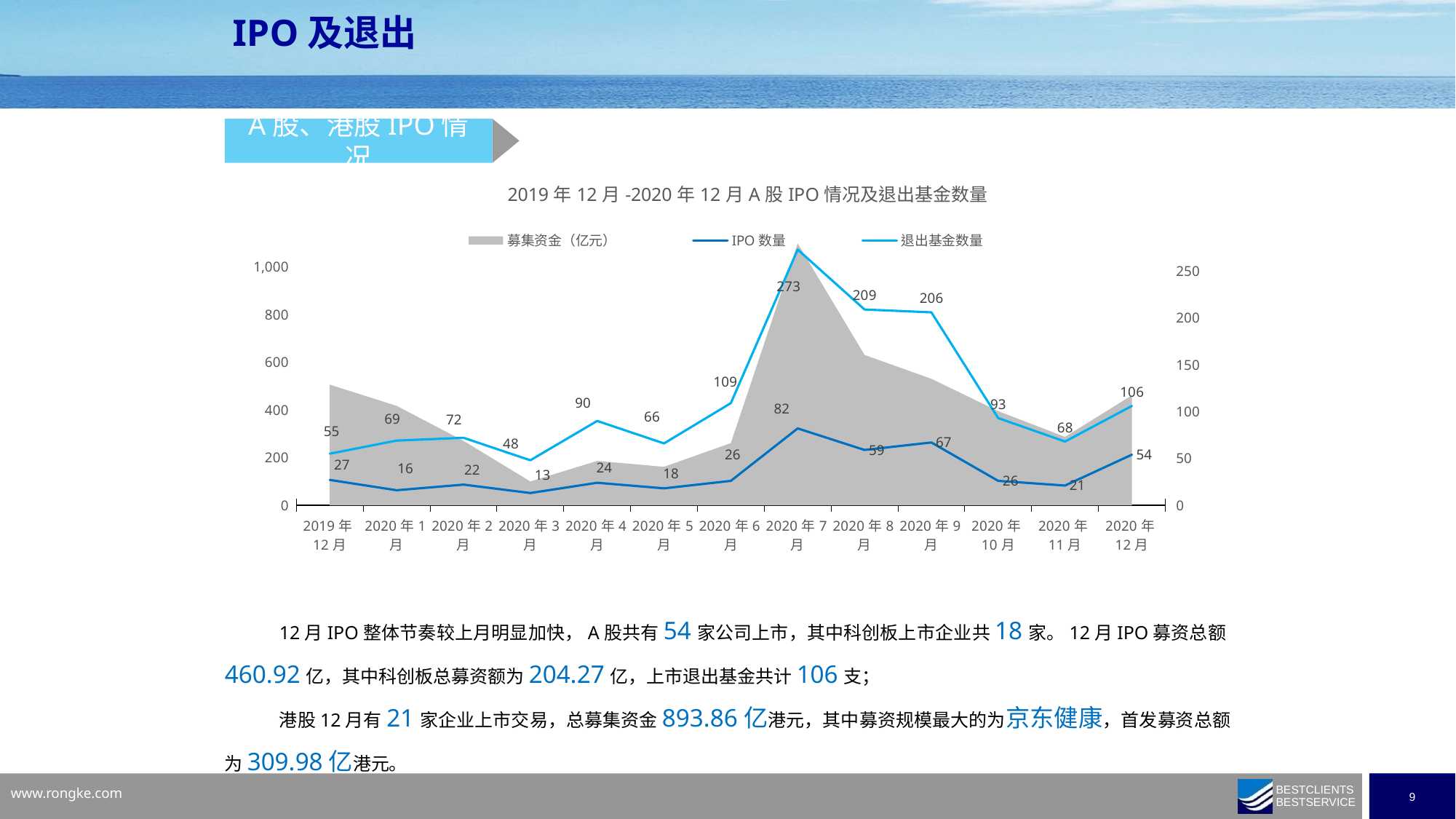
Does the 退出基金数量 rise or fall from 2020 年 7 月 to 2020 年 11 月? fall In which month is the 退出基金数量 highest? 2020 年 7 月 What is the 退出基金数量 value for 2020 年 12 月? 106 What is the 退出基金数量 value for 2019 年 12 月? 55 Which month has a larger IPO 数量, 2020 年 8 月 or 2020 年 9 月? 2020 年 9 月 How many series does the legend list? 3 In which month is the IPO 数量 lowest? 2020 年 3 月 What is the IPO 数量 value for 2020 年 7 月? 82 What is the difference between the IPO 数量 for 2020 年 12 月 and 2020 年 11 月? 33 Is the 募集资金 value for 2020 年 7 月 greater or less than 800 on the left axis? greater What is the difference between the 退出基金数量 for 2020 年 8 月 and 2020 年 9 月? 3 How many months are shown on the x axis? 13